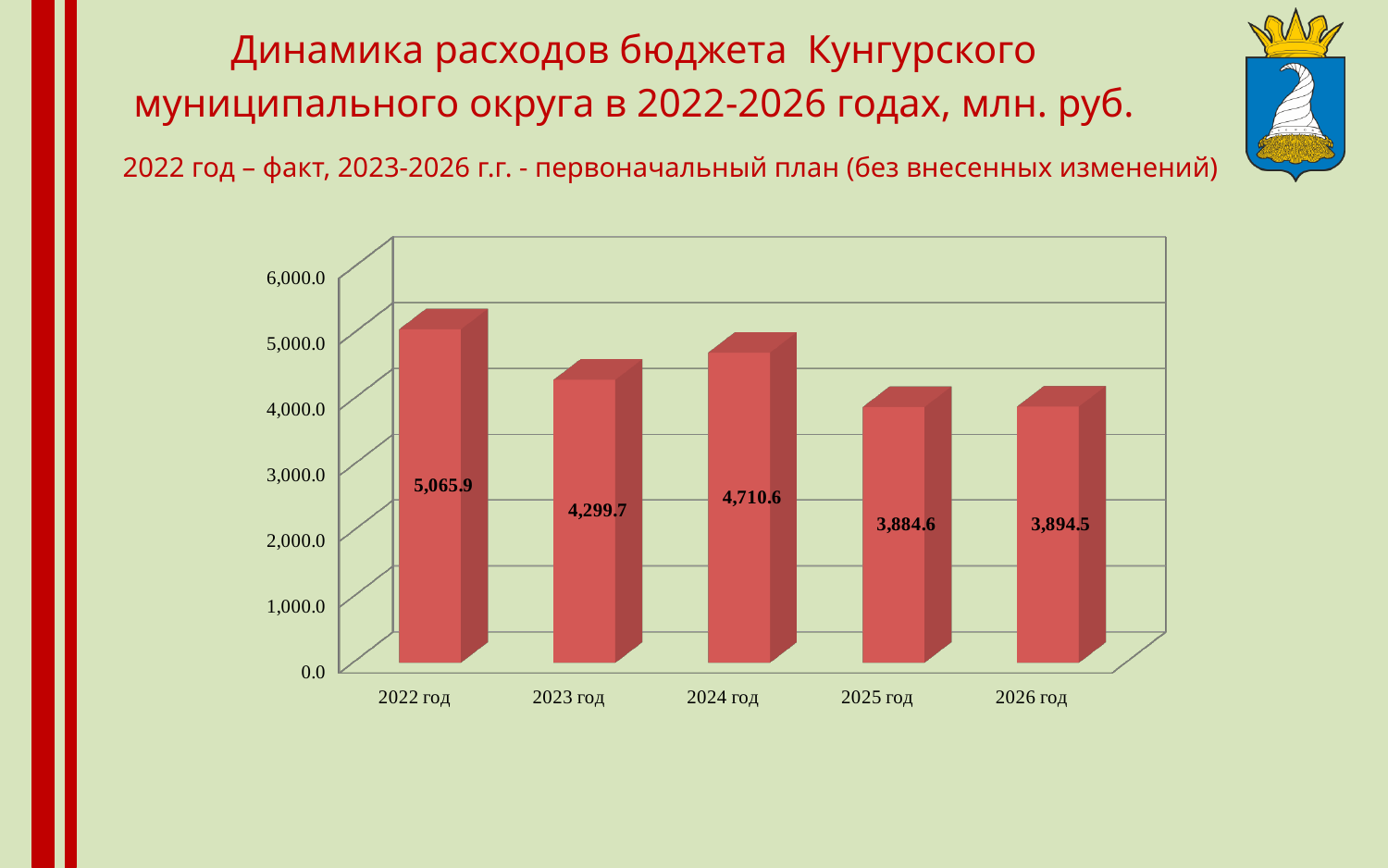
Which is larger, the value for 2023 год or the value for 2024 год? 2024 год How many years (bars) are shown on the chart? 5 What is the budget expenditure value shown for 2022 год? 5,065.9 What is the difference between the values for 2024 год and 2025 год? 826.0 Is the value for 2023 год greater or less than 4,000.0? greater What value is shown for 2026 год? 3,894.5 What value is shown for 2024 год? 4,710.6 Is the value for 2025 год greater or less than 4,000.0? less What is the difference between the values for 2022 год and 2023 год? 766.2 Which year has the highest value on the chart? 2022 год What kind of chart is shown on the slide? bar chart Overall, do the values rise or fall from 2022 год to 2026 год? fall